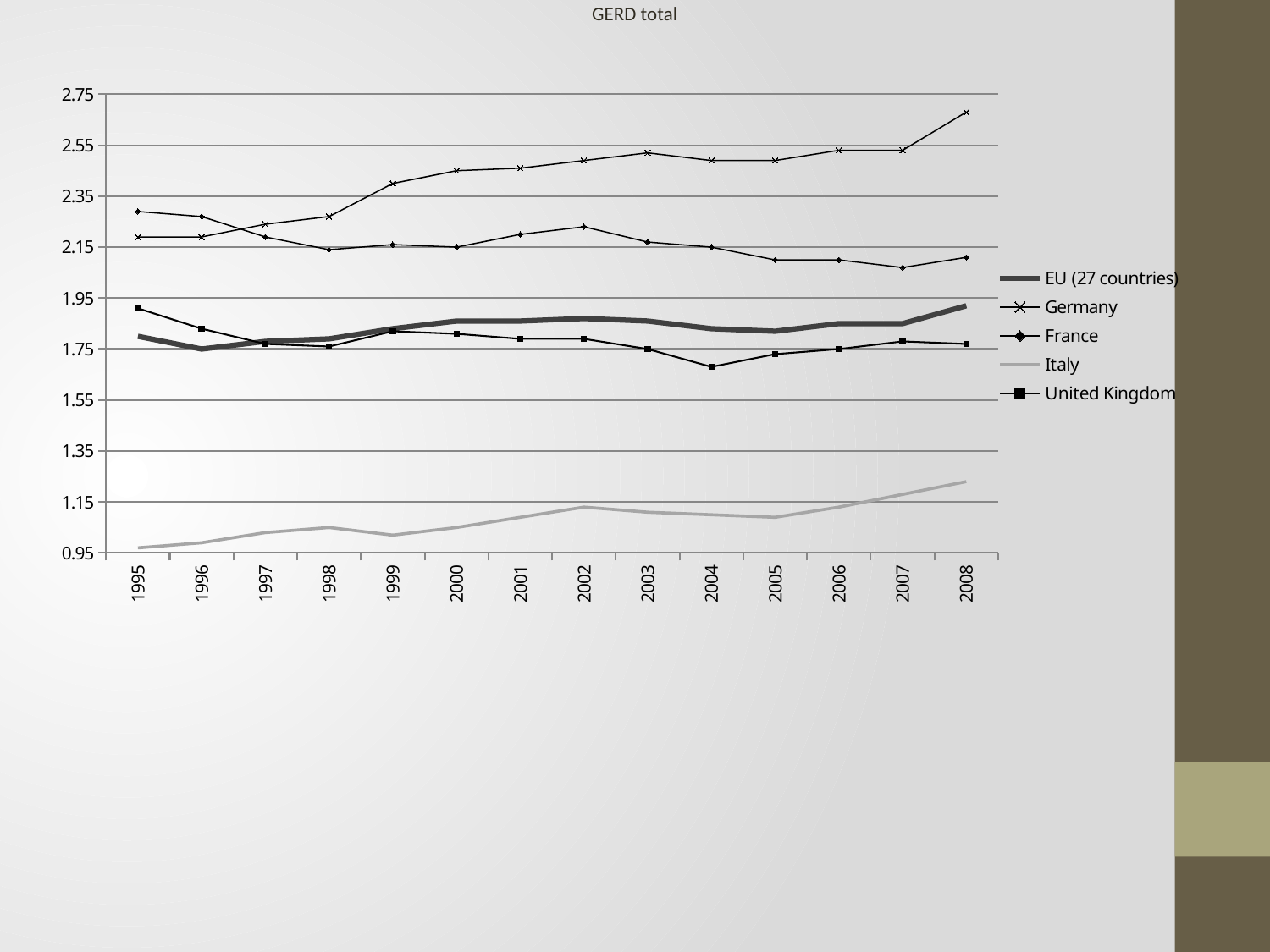
How many series does the legend list? 5 What kind of chart is shown on the slide? line chart Is the value for United Kingdom in 2004 greater or less than 1.75? less Is the value for Italy in 1995 greater or less than 1.15? less Is the value for Germany in 2008 greater or less than 2.55? greater In 1995, which is higher: Germany or France? France What is the title of the chart? GERD total In 2008, which is higher: EU (27 countries) or United Kingdom? EU (27 countries) How many years are plotted along the x axis? 14 Does the Italy series rise or fall from 1995 to 2008? rise Which series has the highest value in 2008? Germany Which series has the lowest value in 2008? Italy